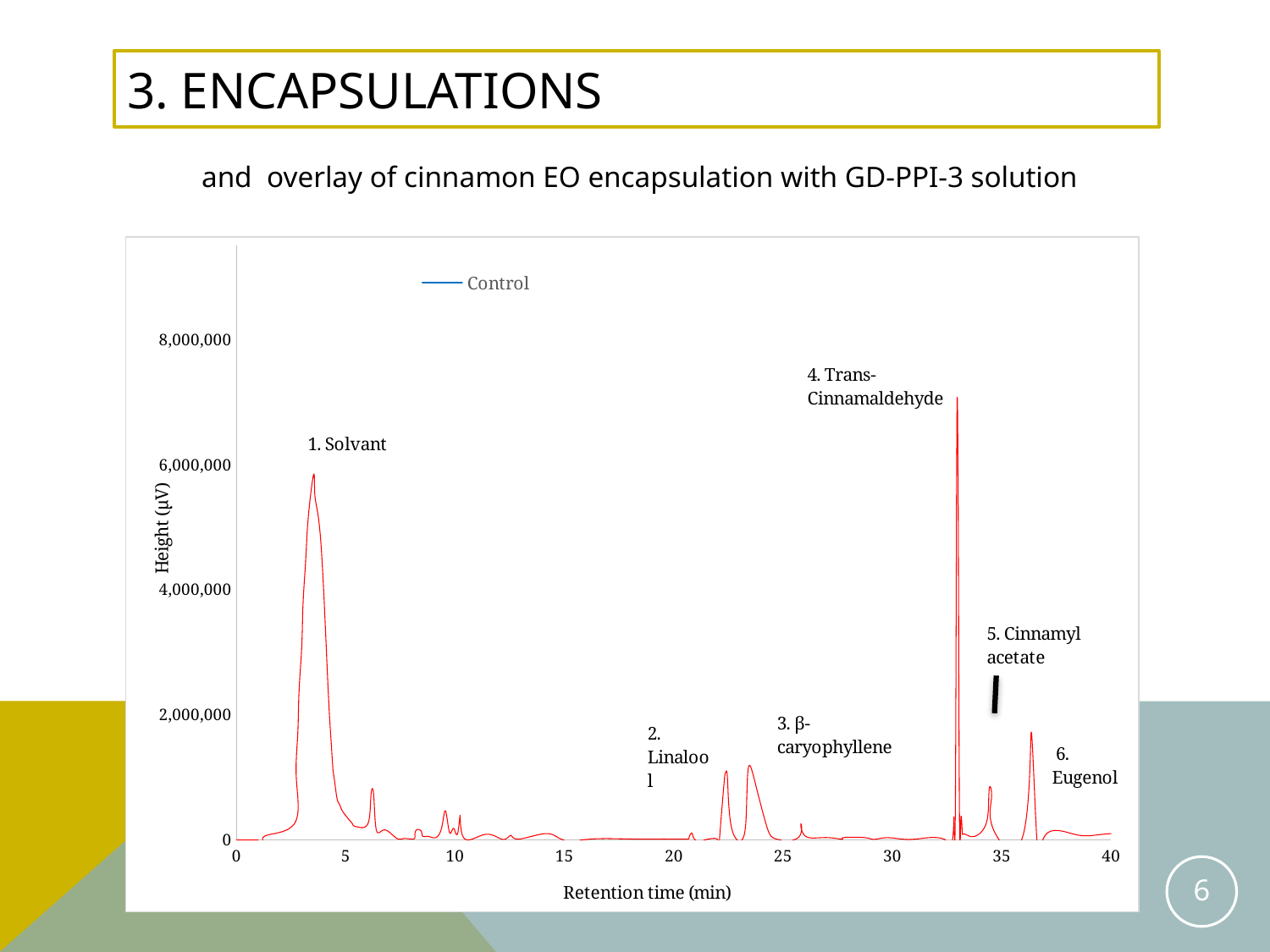
Is the peak height for Solvant greater or less than 4,000,000? greater What kind of chart is shown on the slide? line chart How many series does the legend list? 1 What is the name of the series shown in the legend? Control Is the peak height for Eugenol greater or less than 2,000,000? less Which peak is taller, Solvant or Eugenol? Solvant Is the peak height for Linalool greater or less than 2,000,000? less How many numbered peaks are labelled on the chart? 6 What is the label of the x axis? Retention time (min) Which peak is taller, Trans-Cinnamaldehyde or β-caryophyllene? Trans-Cinnamaldehyde Which labelled peak has the greatest height? 4. Trans-Cinnamaldehyde